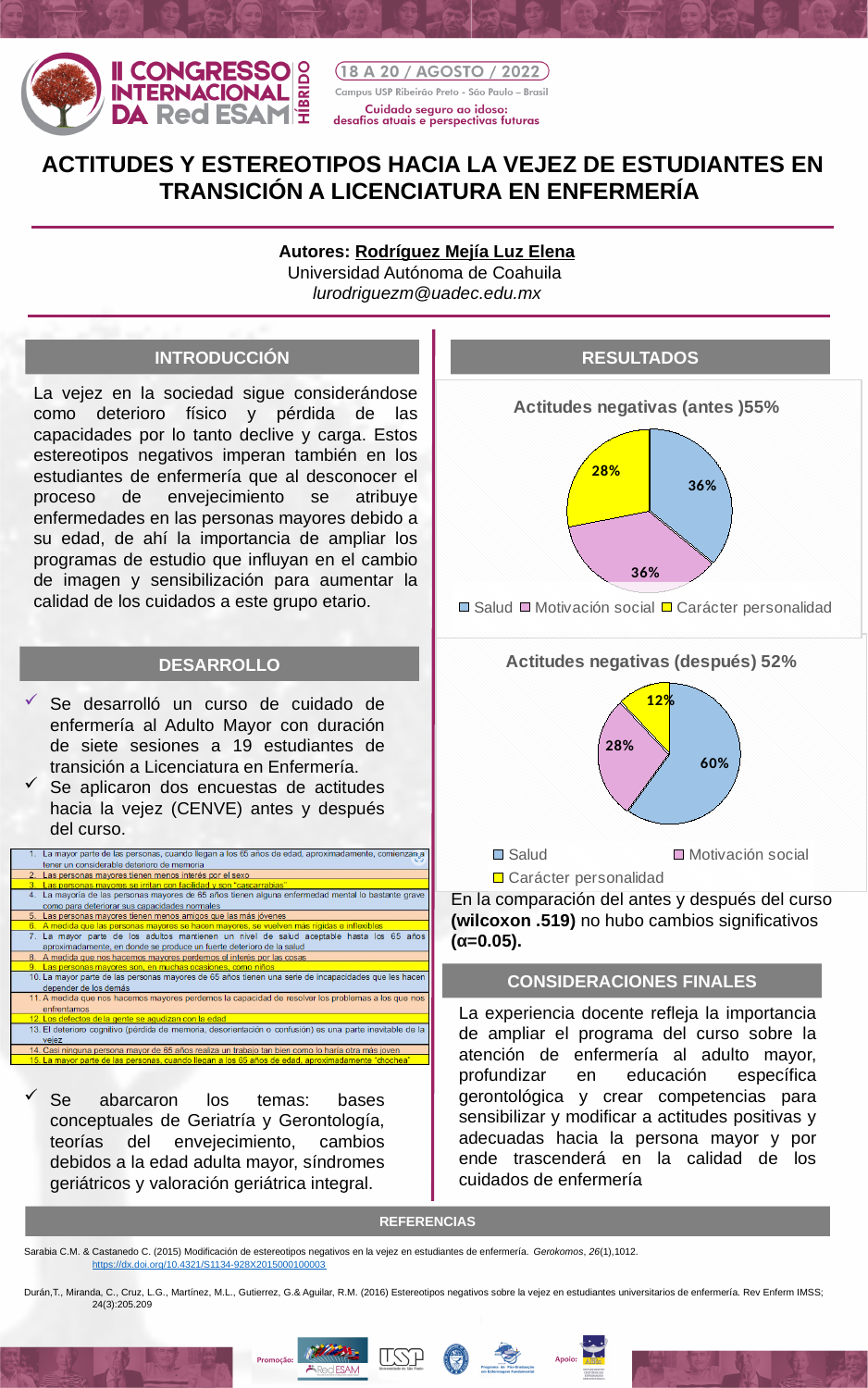
In the 'Actitudes negativas (después) 52%' chart, which category has the smallest slice? Carácter personalidad In the 'Actitudes negativas (después) 52%' chart, what is the share for Motivación social? 28% How many categories does the legend of the 'Actitudes negativas (después) 52%' chart list? 3 What type of chart is used for 'Actitudes negativas (antes )55%'? pie chart In the 'Actitudes negativas (después) 52%' chart, what is the share for Salud? 60% In the 'Actitudes negativas (antes )55%' chart, which category has the smallest slice? Carácter personalidad In the 'Actitudes negativas (después) 52%' chart, which category has the largest slice? Salud In the 'Actitudes negativas (después) 52%' chart, what is the share for Carácter personalidad? 12% In the 'Actitudes negativas (antes )55%' chart, what is the share for Salud? 36% In the 'Actitudes negativas (antes )55%' chart, what is the share for Carácter personalidad? 28% How many slices does the 'Actitudes negativas (antes )55%' pie chart have? 3 In the 'Actitudes negativas (después) 52%' chart, what is the difference between the Salud and Motivación social shares? 32%